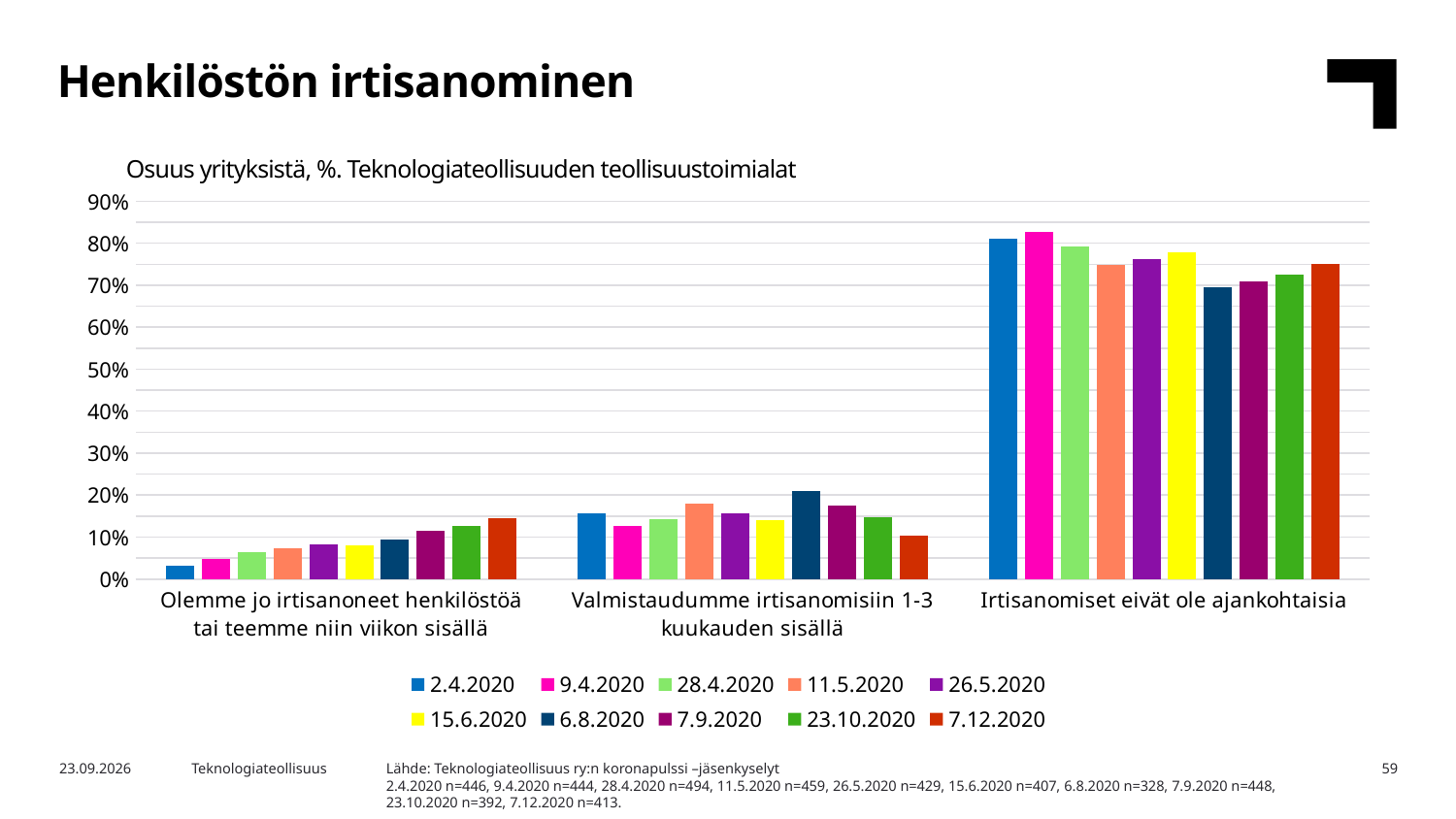
Do the values in the category 'Olemme jo irtisanoneet henkilöstöä tai teemme niin viikon sisällä' generally rise or fall from 2.4.2020 to 7.12.2020? rise In the category 'Valmistaudumme irtisanomisiin 1-3 kuukauden sisällä', which series has the lowest value? 7.12.2020 How many series does the legend list? 10 In the category 'Valmistaudumme irtisanomisiin 1-3 kuukauden sisällä', which series has the highest value? 6.8.2020 In the category 'Olemme jo irtisanoneet henkilöstöä tai teemme niin viikon sisällä', which series has the lowest value? 2.4.2020 Which category has the highest bars overall? Irtisanomiset eivät ole ajankohtaisia In the category 'Irtisanomiset eivät ole ajankohtaisia', which is larger: the value for 2.4.2020 or the value for 6.8.2020? 2.4.2020 Is the value for 9.4.2020 in the category 'Irtisanomiset eivät ole ajankohtaisia' greater or less than 80%? greater Is the value for 6.8.2020 in the category 'Valmistaudumme irtisanomisiin 1-3 kuukauden sisällä' greater or less than 20%? greater How many categories are shown on the x axis of the chart? 3 Is the value for 2.4.2020 in the category 'Olemme jo irtisanoneet henkilöstöä tai teemme niin viikon sisällä' greater or less than 10%? less What kind of chart is shown on the slide? Bar chart